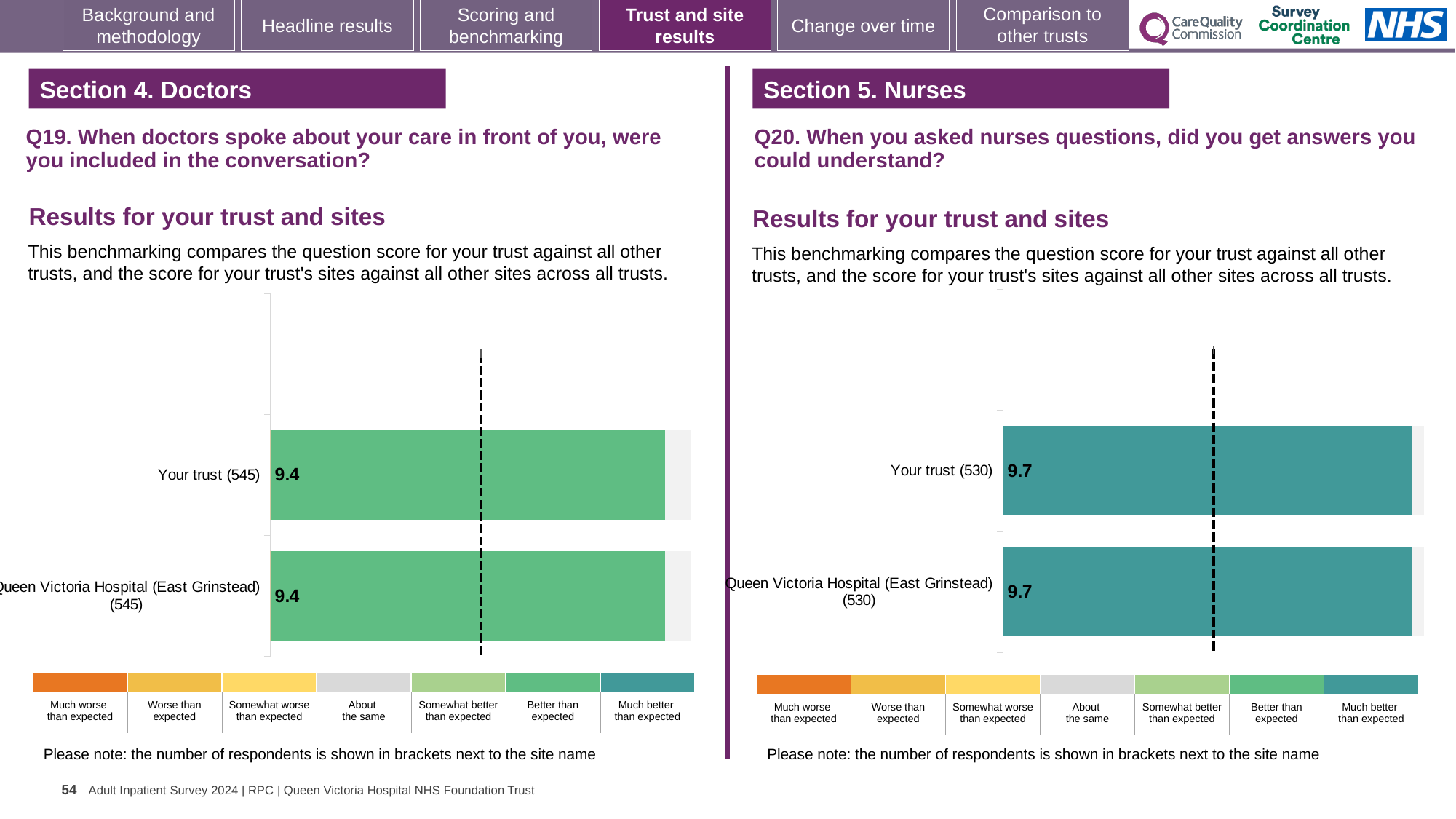
How many bars are plotted in the Q20 chart on the right? 2 What kind of chart is used for the Q19 results on the left? Bar chart In the Q20 chart on the right, what is the difference between the score for Your trust and the score for Queen Victoria Hospital (East Grinstead)? 0 How many bars are plotted in the Q19 chart on the left? 2 In the Q20 chart on the right, what is the score for Queen Victoria Hospital (East Grinstead) (530)? 9.7 How many respondents are shown in brackets for Your trust in the Q20 chart on the right? 530 According to the colour key below the Q20 chart on the right, which benchmark category do the teal bars represent? Much better than expected In the Q19 chart on the left, what is the score for Your trust (545)? 9.4 In the Q19 chart on the left, what is the difference between the score for Your trust and the score for Queen Victoria Hospital (East Grinstead)? 0 In the Q20 chart on the right, what is the score for Your trust (530)? 9.7 In the Q19 chart on the left, what is the score for Queen Victoria Hospital (East Grinstead) (545)? 9.4